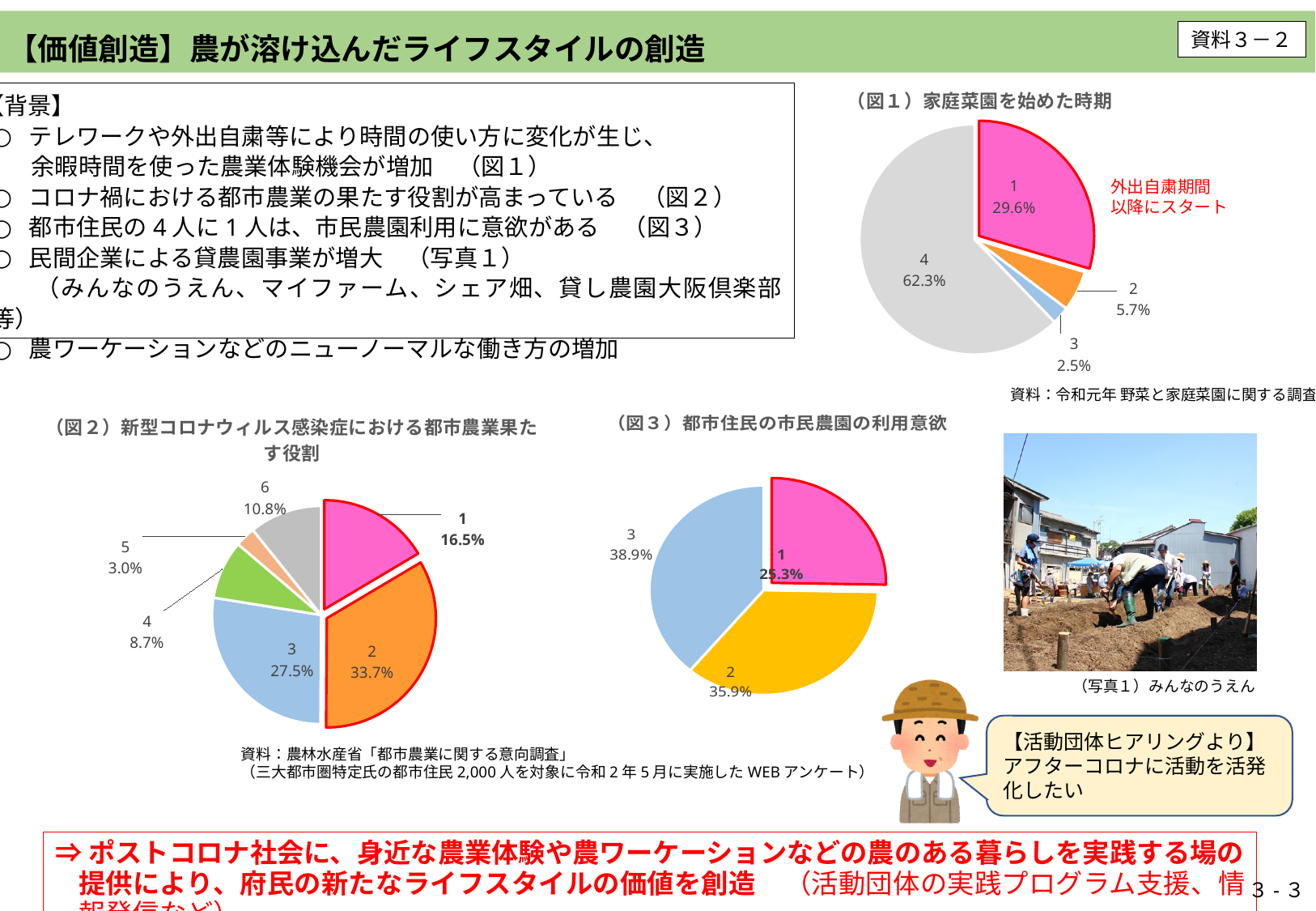
In the chart titled （図２）新型コロナウィルス感染症における都市農業果たす役割, how many categories are shown? 6 In the chart titled （図１）家庭菜園を始めた時期, how many categories are shown? 4 What kind of chart is （図３）都市住民の市民農園の利用意欲? pie chart In the chart titled （図３）都市住民の市民農園の利用意欲, which is larger, category 2 or category 3? 3 In the chart titled （図１）家庭菜園を始めた時期, which category has the largest share? 4 In the chart titled （図２）新型コロナウィルス感染症における都市農業果たす役割, what is the difference between category 2 and category 3? 6.2% In the chart titled （図２）新型コロナウィルス感染症における都市農業果たす役割, what is the value for category 2? 33.7% In the chart titled （図１）家庭菜園を始めた時期, which category has the smallest share? 3 In the chart titled （図３）都市住民の市民農園の利用意欲, what is the value for category 1? 25.3% In the chart titled （図３）都市住民の市民農園の利用意欲, what is the difference between category 3 and category 1? 13.6% In the chart titled （図１）家庭菜園を始めた時期, what is the value for category 1? 29.6% In the chart titled （図２）新型コロナウィルス感染症における都市農業果たす役割, which category has the smallest share? 5